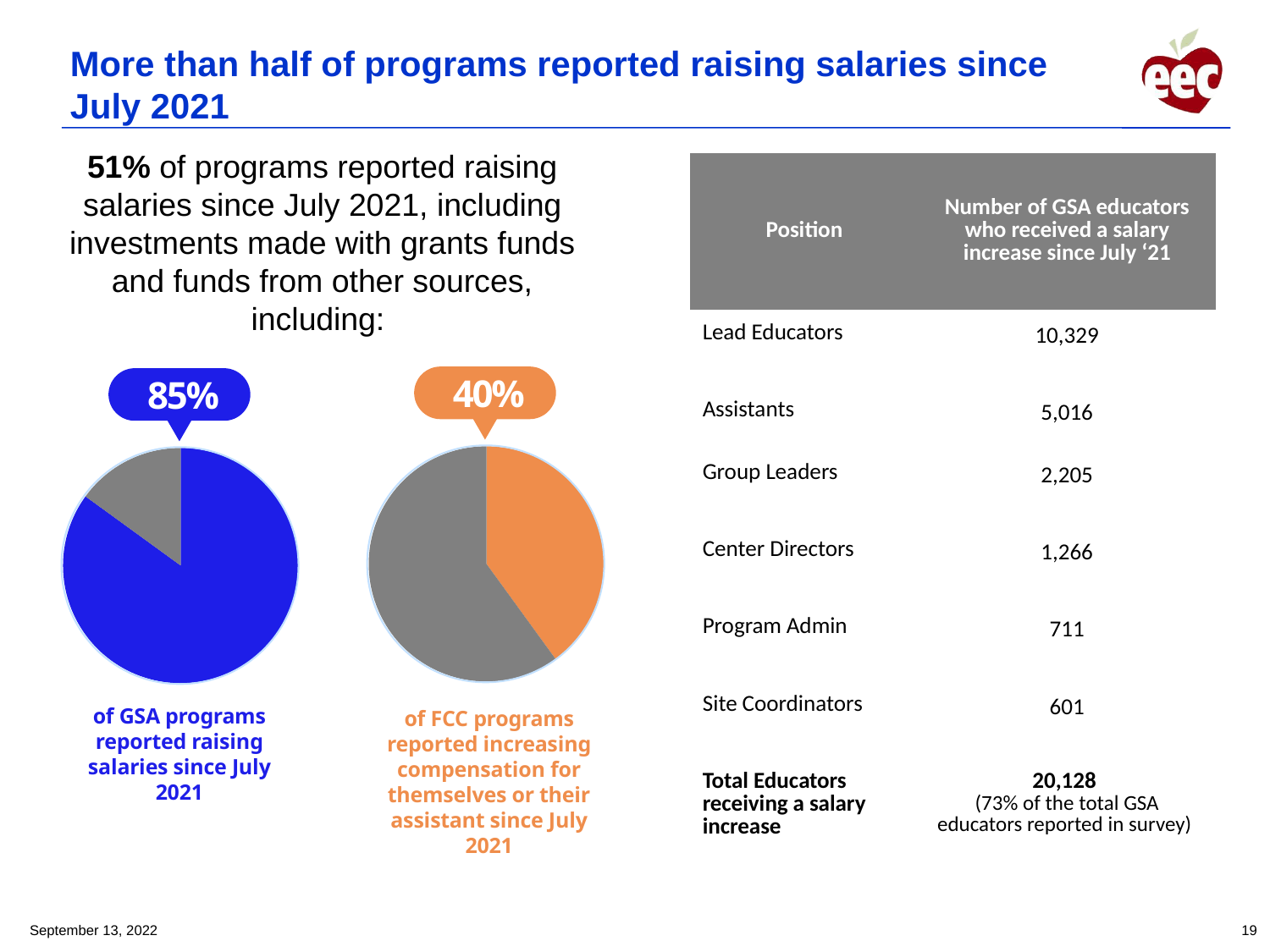
Which is larger: the share of GSA programs that reported raising salaries (left pie) or the share of FCC programs that reported increasing compensation (right pie)? GSA programs What colour is the highlighted slice in the right pie chart for FCC programs? Orange What type of chart is shown on the left side of the slide, below the 85% label? Pie chart What type of chart is shown in the middle of the slide, below the 40% label? Pie chart In the left pie chart, is the highlighted blue slice greater or less than 50%? greater What is the difference in percentage points between the GSA share shown in the left pie chart and the FCC share shown in the right pie chart? 45 percentage points How many pie charts are shown on the slide? 2 In the right pie chart, is the highlighted orange slice greater or less than 50%? less In the left pie chart, what percentage of GSA programs reported raising salaries since July 2021? 85% What colour is the highlighted slice in the left pie chart for GSA programs? Blue In the right pie chart, what percentage of FCC programs reported increasing compensation for themselves or their assistant since July 2021? 40% How many slices does the left pie chart have? 2